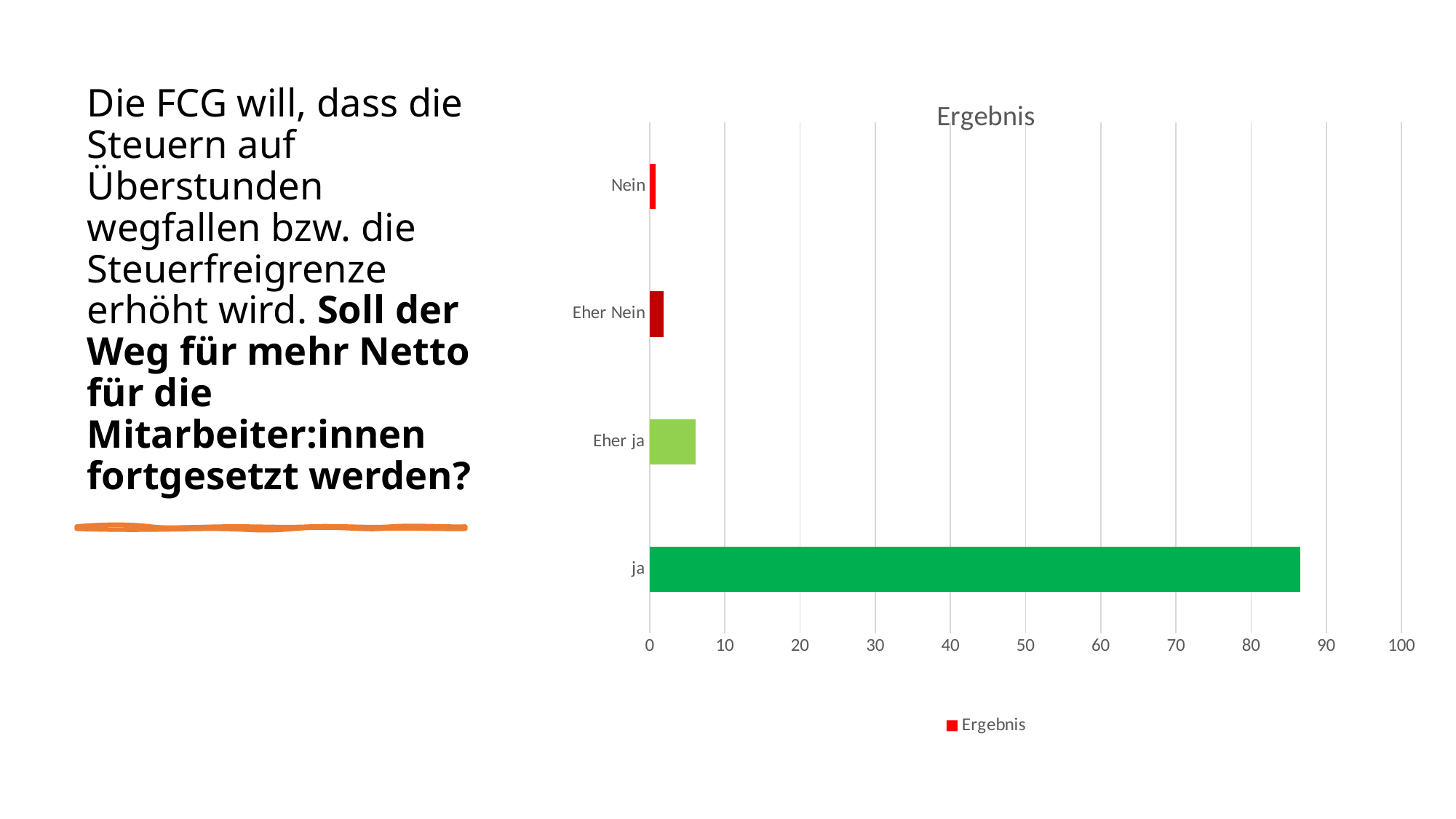
Is the value for ja greater or less than 80? greater What is the title of the chart? Ergebnis How many categories are shown on the chart? 4 Which is larger, the value for Eher ja or the value for Eher Nein? Eher ja Which category has the highest value? ja Which is larger, the value for ja or the value for Eher ja? ja What is the name of the series listed in the legend? Ergebnis Is the value for Eher Nein greater or less than 10? less How many series does the legend list? 1 What kind of chart is shown on the slide? bar chart Which category has the lowest value? Nein Is the value for Eher ja greater or less than 10? less